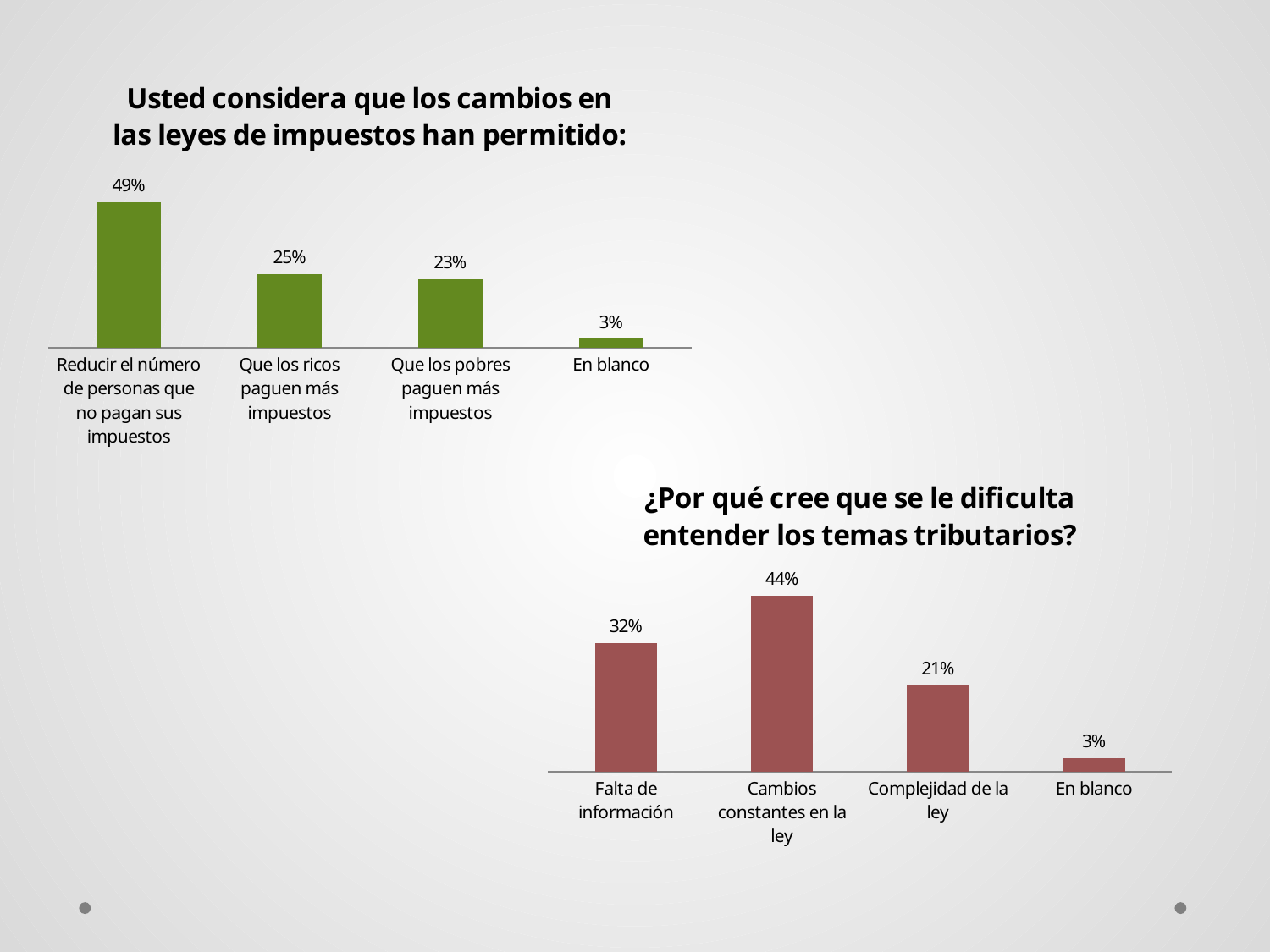
What colour are the bars in the chart titled "Usted considera que los cambios en las leyes de impuestos han permitido:"? Green In the chart titled "Usted considera que los cambios en las leyes de impuestos han permitido:", which category has the highest value? Reducir el número de personas que no pagan sus impuestos In the chart titled "Usted considera que los cambios en las leyes de impuestos han permitido:", which category has the lowest value? En blanco In the chart titled "¿Por qué cree que se le dificulta entender los temas tributarios?", which category has the highest value? Cambios constantes en la ley In the chart titled "¿Por qué cree que se le dificulta entender los temas tributarios?", what is the difference between "Cambios constantes en la ley" and "Falta de información"? 12% What kind of chart is the one titled "¿Por qué cree que se le dificulta entender los temas tributarios?"? Bar chart In the chart titled "Usted considera que los cambios en las leyes de impuestos han permitido:", how many categories are shown? 4 In the chart titled "Usted considera que los cambios en las leyes de impuestos han permitido:", what is the difference between "Reducir el número de personas que no pagan sus impuestos" and "Que los pobres paguen más impuestos"? 26% In the chart titled "¿Por qué cree que se le dificulta entender los temas tributarios?", what is the value for "Complejidad de la ley"? 21% In the chart titled "¿Por qué cree que se le dificulta entender los temas tributarios?", which is larger: "Falta de información" or "Complejidad de la ley"? Falta de información In the chart titled "Usted considera que los cambios en las leyes de impuestos han permitido:", what is the value for "Que los ricos paguen más impuestos"? 25% In the chart titled "¿Por qué cree que se le dificulta entender los temas tributarios?", what is the value for "En blanco"? 3%